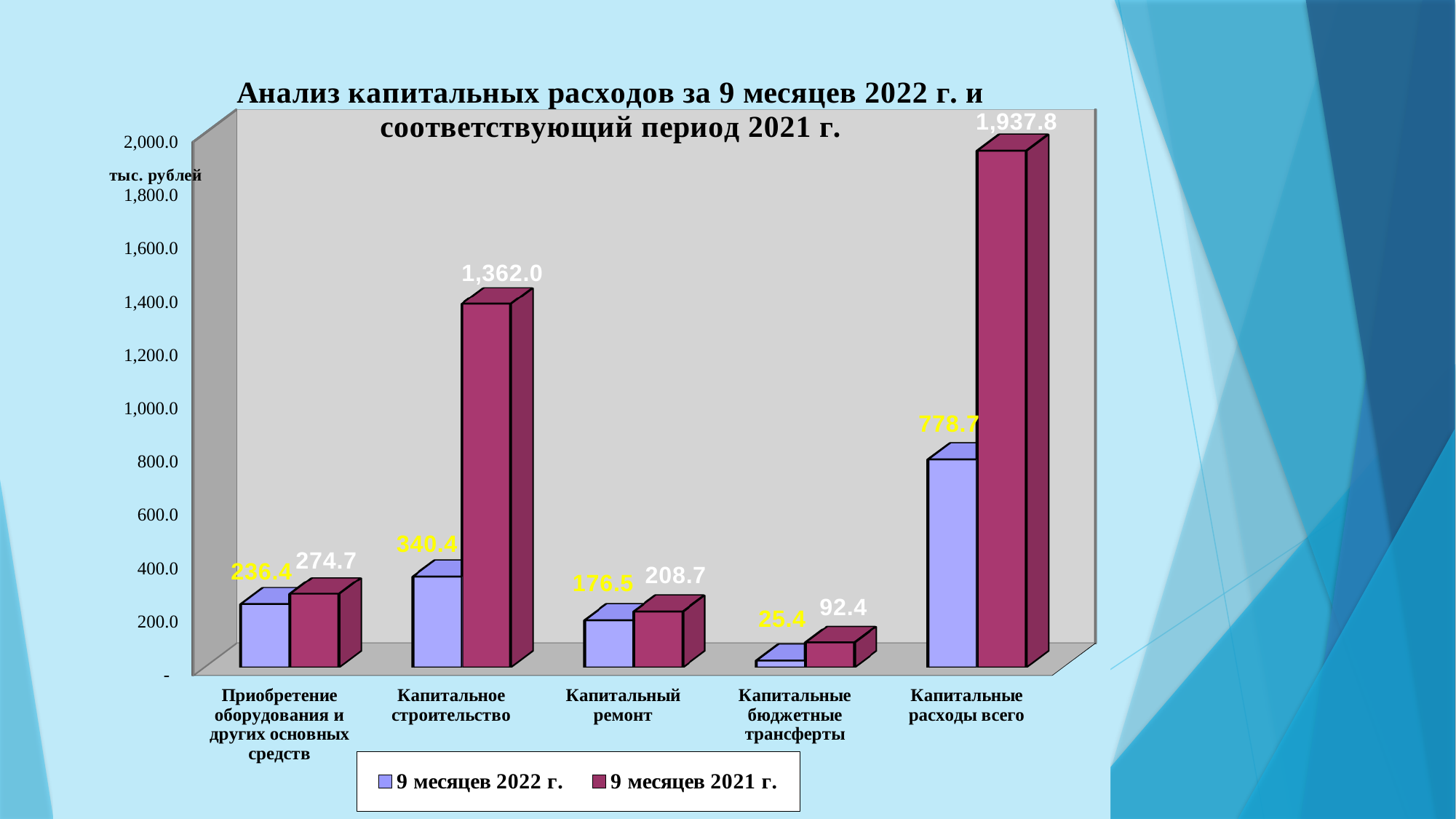
What is the value for Капитальное строительство in the 9 месяцев 2021 г. series? 1,362.0 What is the value for Капитальный ремонт in the 9 месяцев 2021 г. series? 208.7 How many categories are shown on the x axis? 5 What is the difference between the 9 месяцев 2021 г. and 9 месяцев 2022 г. values for Капитальные расходы всего? 1,159.1 What kind of chart is shown on the slide? bar chart Is the 9 месяцев 2021 г. value for Капитальное строительство greater or less than 1,200.0? greater How many series does the legend list? 2 Which category has the lowest value in the 9 месяцев 2021 г. series? Капитальные бюджетные трансферты Which is larger for Приобретение оборудования и других основных средств: the 9 месяцев 2022 г. value or the 9 месяцев 2021 г. value? 9 месяцев 2021 г. What is the value for Капитальные бюджетные трансферты in the 9 месяцев 2022 г. series? 25.4 What unit is shown on the vertical axis of the chart? тыс. рублей Which category has the highest value in the 9 месяцев 2022 г. series? Капитальные расходы всего